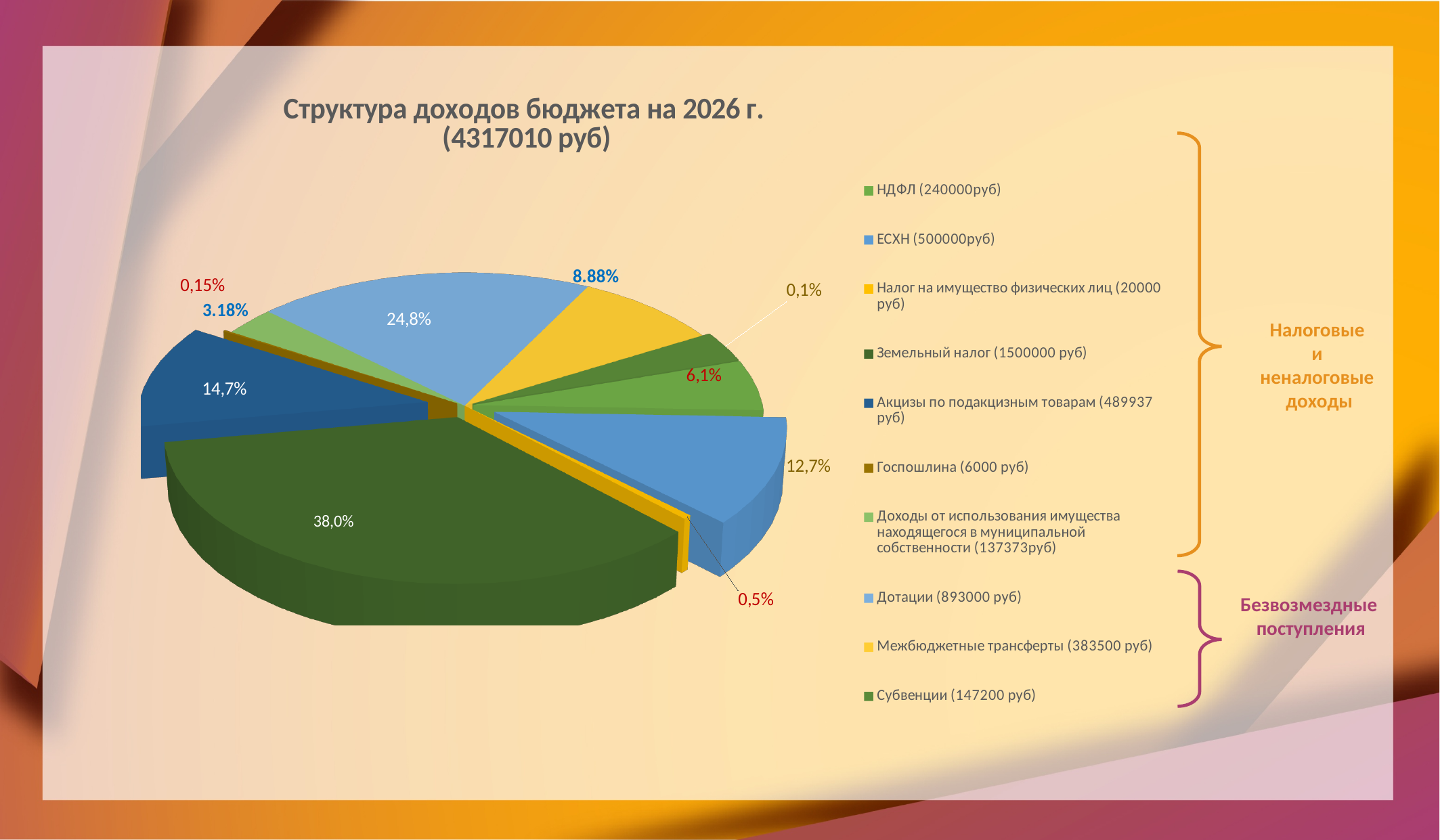
What is the smallest percentage label shown on the pie? 0,1% Which category has the largest slice of the pie? Земельный налог What is the difference between the 38,0% slice and the 14,7% slice? 23,3% What percentage is labelled on the Акцизы по подакцизным товарам slice (dark blue)? 14,7% According to the legend, what amount is given for Земельный налог? 1500000 руб What is the title of the chart? Структура доходов бюджета на 2026 г. (4317010 руб) What share of the pie does the Земельный налог slice (dark green) take? 38,0% How many entries does the chart legend list? 10 Which is larger: the Земельный налог slice or the Акцизы по подакцизным товарам slice? Земельный налог What percentage is labelled on the Доходы от использования имущества slice (light green)? 3.18% According to the legend, what amount is given for Дотации? 893000 руб What kind of chart is shown on the slide? pie chart